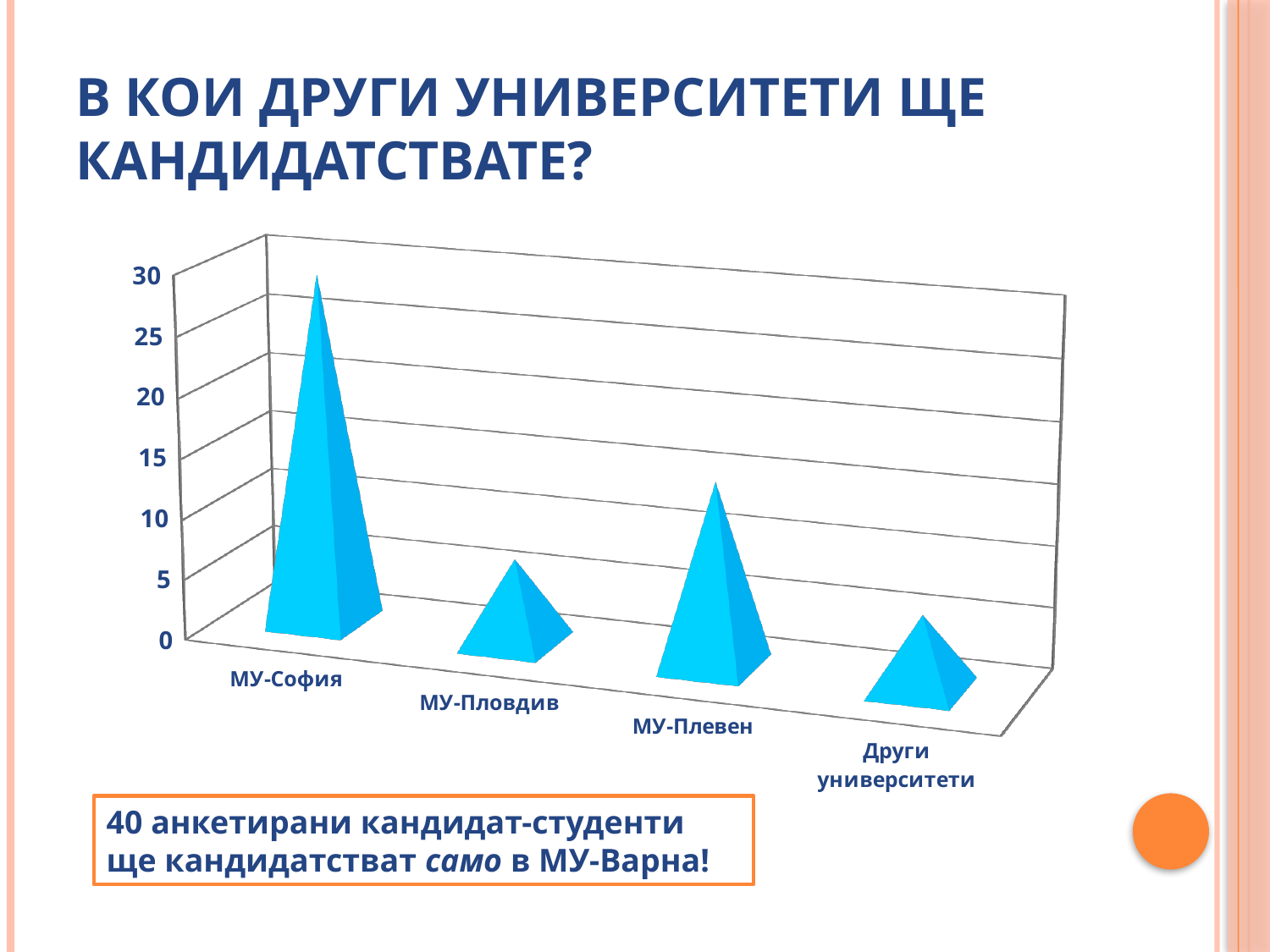
Is the value for МУ-Пловдив greater or less than 10? less Is the value for Други университети greater or less than 10? less Which is larger, the value for МУ-София or the value for МУ-Плевен? МУ-София Which category has the highest value in the chart? МУ-София Is the value for МУ-Плевен greater or less than 20? less Which is larger, the value for МУ-Плевен or the value for МУ-Пловдив? МУ-Плевен What is the title of the slide containing the chart? В кои други университети ще кандидатствате? What is the highest value shown on the vertical axis of the chart? 30 What kind of chart is shown on the slide? bar chart How many categories are shown on the x axis of the chart? 4